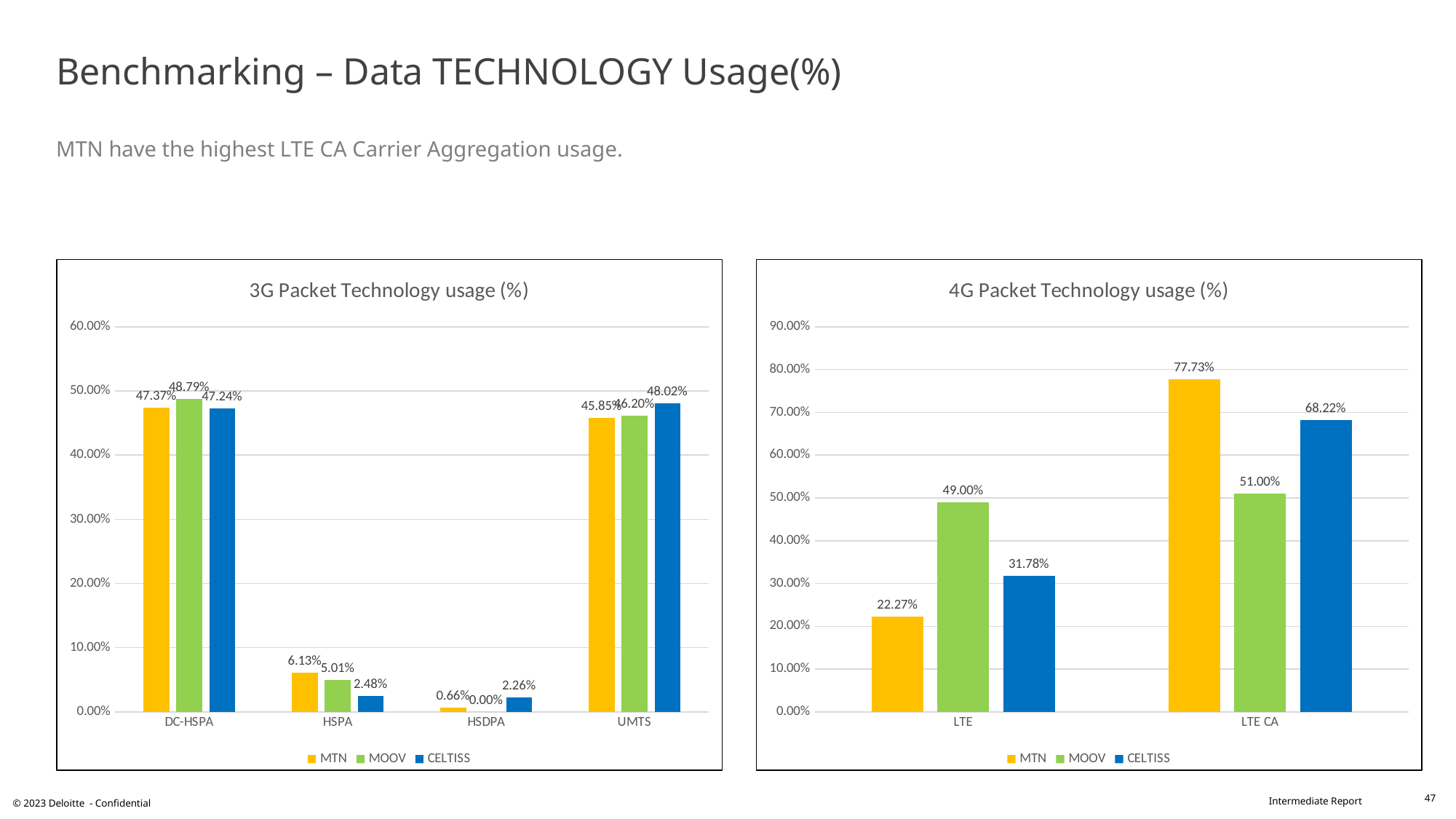
In the 4G Packet Technology usage (%) chart, is the value for CELTISS in the LTE category greater or less than 40.00%? less In the 4G Packet Technology usage (%) chart, which colour represents CELTISS? Blue What kind of chart is the 4G Packet Technology usage (%) chart? Bar chart In the 4G Packet Technology usage (%) chart, what is the difference between the MTN and MOOV values in the LTE CA category? 26.73% In the 3G Packet Technology usage (%) chart, which is larger in the UMTS category: the MTN value or the CELTISS value? CELTISS In the 3G Packet Technology usage (%) chart, what is the value for MOOV in the HSDPA category? 0.00% In the 4G Packet Technology usage (%) chart, what is the value for MTN in the LTE CA category? 77.73% In the 3G Packet Technology usage (%) chart, what is the value for CELTISS in the HSPA category? 2.48% In the 3G Packet Technology usage (%) chart, which operator has the lowest value in the HSPA category? CELTISS In the 4G Packet Technology usage (%) chart, which operator has the highest value in the LTE category? MOOV How many categories are shown on the x axis of the 3G Packet Technology usage (%) chart? 4 How many series does the legend of the 4G Packet Technology usage (%) chart list? 3